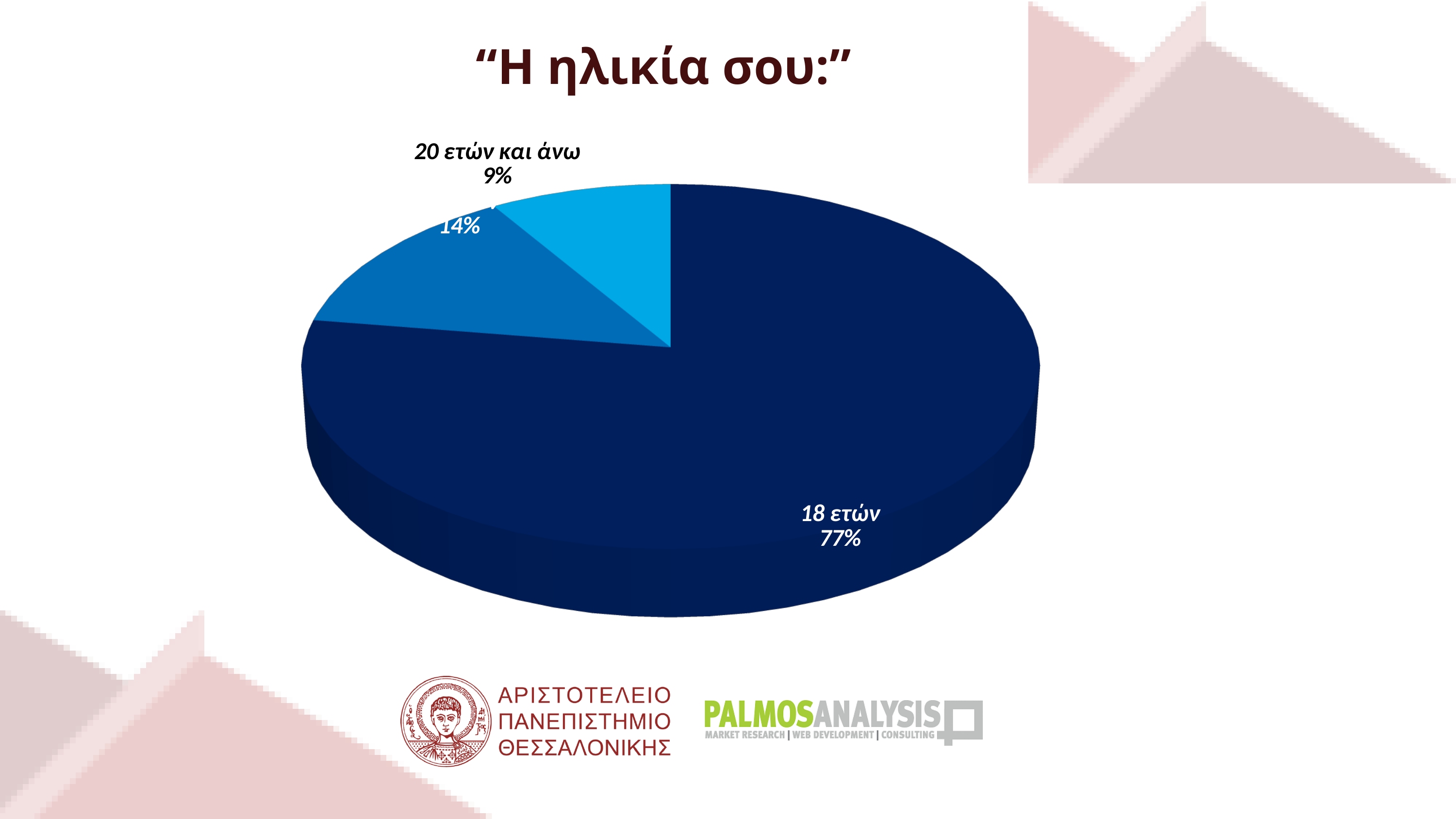
What is the title of the chart? "Η ηλικία σου:" What share of the pie does the 18 ετών slice represent? 77% What colour is the largest slice of the pie? Dark navy blue How many slices does the pie chart have? 3 What kind of chart is shown on the slide? Pie chart What percentage of respondents are 18 ετών? 77% Which is larger, the share for 18 ετών or the share for 20 ετών και άνω? 18 ετών Is the share for 18 ετών greater or less than 50%? greater Which age category has the smallest share of the pie? 20 ετών και άνω What percentage of respondents are 20 ετών και άνω? 9% What is the difference in percentage points between the 18 ετών slice and the 20 ετών και άνω slice? 68 percentage points Which age category has the largest share of the pie? 18 ετών